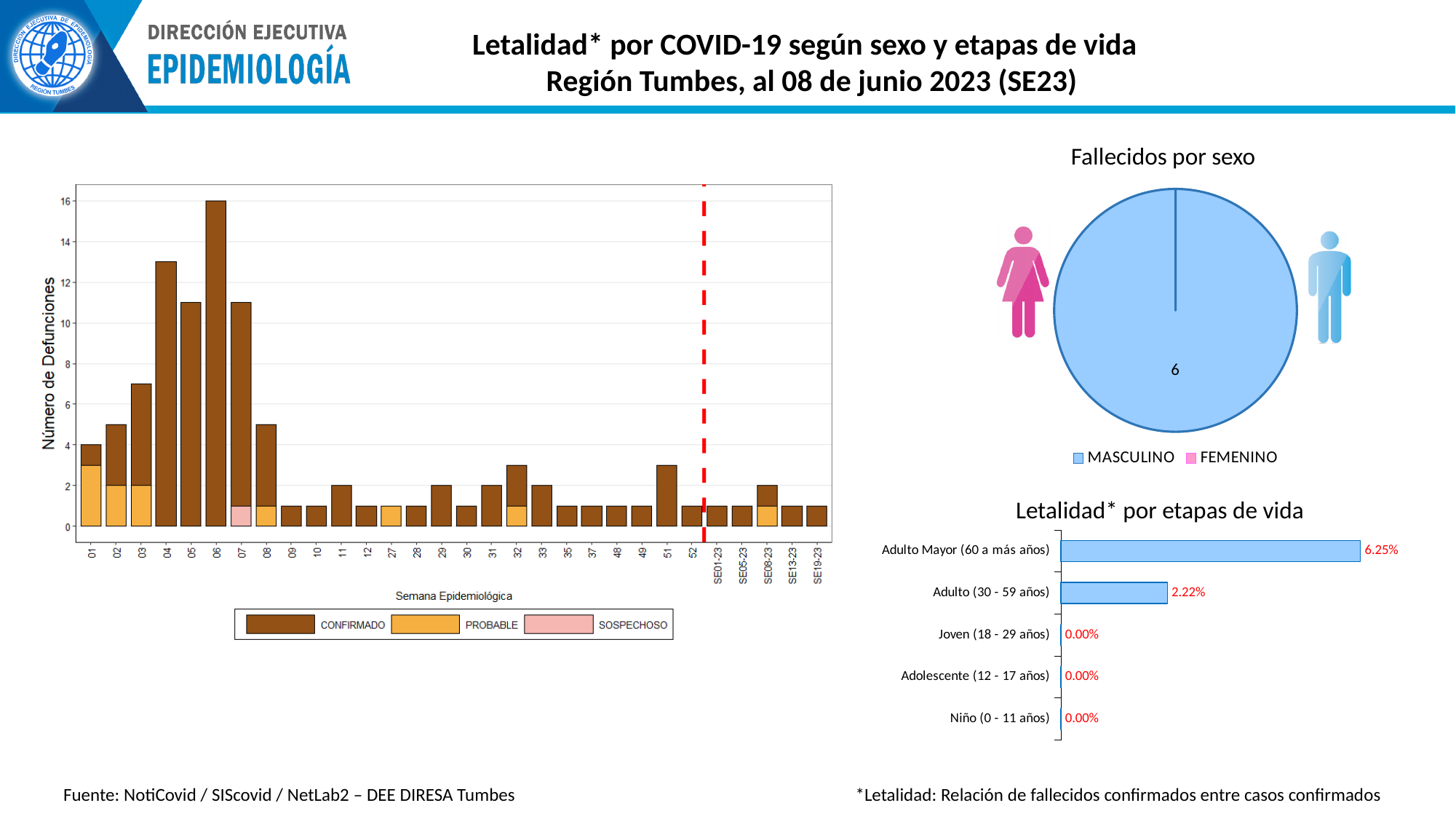
What kind of chart is 'Letalidad* por etapas de vida'? bar chart In the 'Número de Defunciones' bar chart on the left, what is the total height of the bar for week 06? 16 In the 'Número de Defunciones' bar chart on the left, how many series does the legend list? 3 In the 'Fallecidos por sexo' pie chart, what value is printed on the MASCULINO slice? 6 In the 'Letalidad* por etapas de vida' chart, what is the value for Adulto Mayor (60 a más años)? 6.25% How many age groups are shown in the 'Letalidad* por etapas de vida' chart? 5 In the 'Fallecidos por sexo' pie chart, which category makes up the whole pie? MASCULINO How many entries does the legend of the 'Fallecidos por sexo' chart list? 2 In the 'Letalidad* por etapas de vida' chart, what is the difference between the values for Adulto Mayor (60 a más años) and Adulto (30 - 59 años)? 4.03% In the 'Letalidad* por etapas de vida' chart, what is the value for Adulto (30 - 59 años)? 2.22% In the 'Letalidad* por etapas de vida' chart, which age group has the highest value? Adulto Mayor (60 a más años) In the 'Letalidad* por etapas de vida' chart, what is the value for Joven (18 - 29 años)? 0.00%